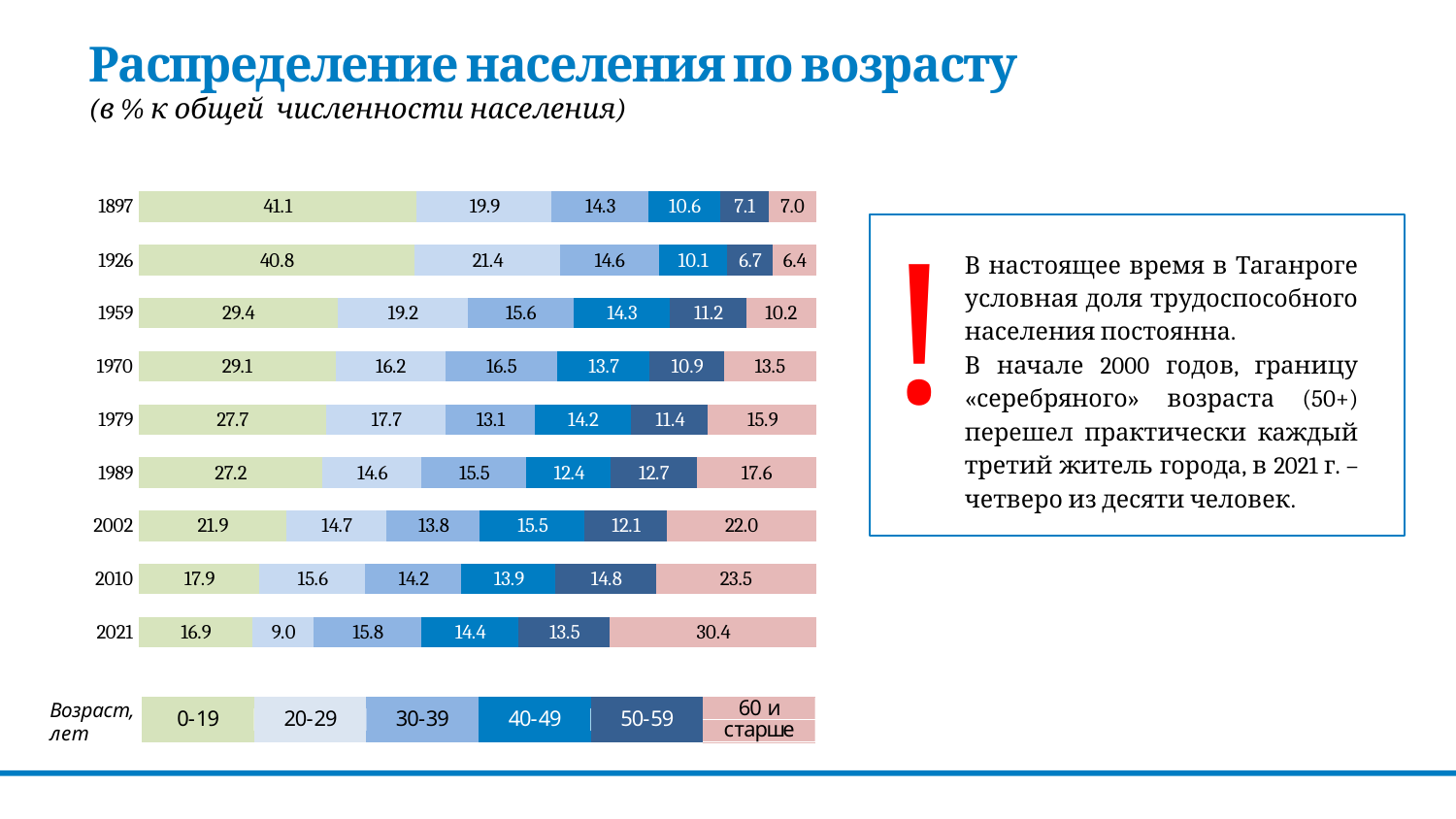
What kind of chart is shown on the slide? Stacked bar chart What is the title of the chart? Распределение населения по возрасту In which year was the share of the 60 и старше group the highest? 2021 What share of the population was aged 0-19 in 1897? 41.1 What is the total of all segments in the 2021 bar? 100.0 In which year was the share of the 20-29 group the lowest? 2021 Does the share of the 0-19 group rise or fall from 1897 to 2021? Falls In 2010, which group had the larger share: 40-49 or 50-59? 50-59 How many years (bars) are shown in the chart? 9 How many age groups does the legend list? 6 What share of the population was aged 60 и старше in 2021? 30.4 By how many percentage points did the share of the 0-19 group fall from 1897 to 2021? 24.2